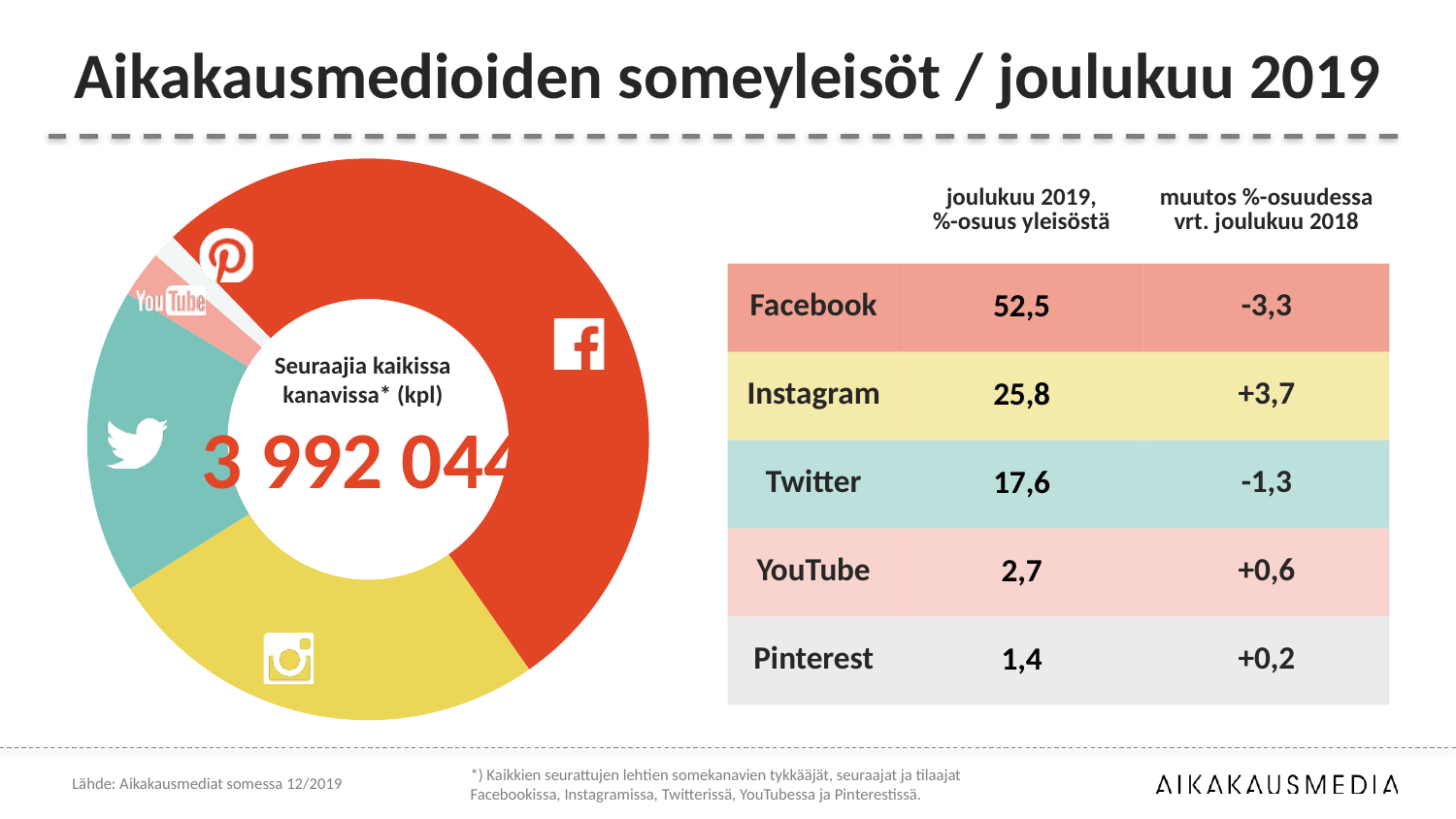
What total number of followers across all channels is printed in the centre of the donut chart? 3 992 044 Which channel has the smallest slice of the donut chart? Pinterest Which channel has the largest slice of the donut chart? Facebook What is the difference in percentage share between Facebook and Instagram in December 2019? 26,7 What is the change in Twitter's percentage share compared with December 2018? -1,3 Which channel's slice in the donut chart is coloured yellow? Instagram How many social media channels are shown as slices in the donut chart? 5 Which slice is larger in the donut chart, Twitter or YouTube? Twitter What is Instagram's share of the audience in December 2019 according to the table? 25,8 What is Facebook's share of the audience in December 2019 according to the table? 52,5 Which channel had the largest increase in percentage share compared with December 2018? Instagram What kind of chart is shown on the left of the slide? Donut (pie) chart